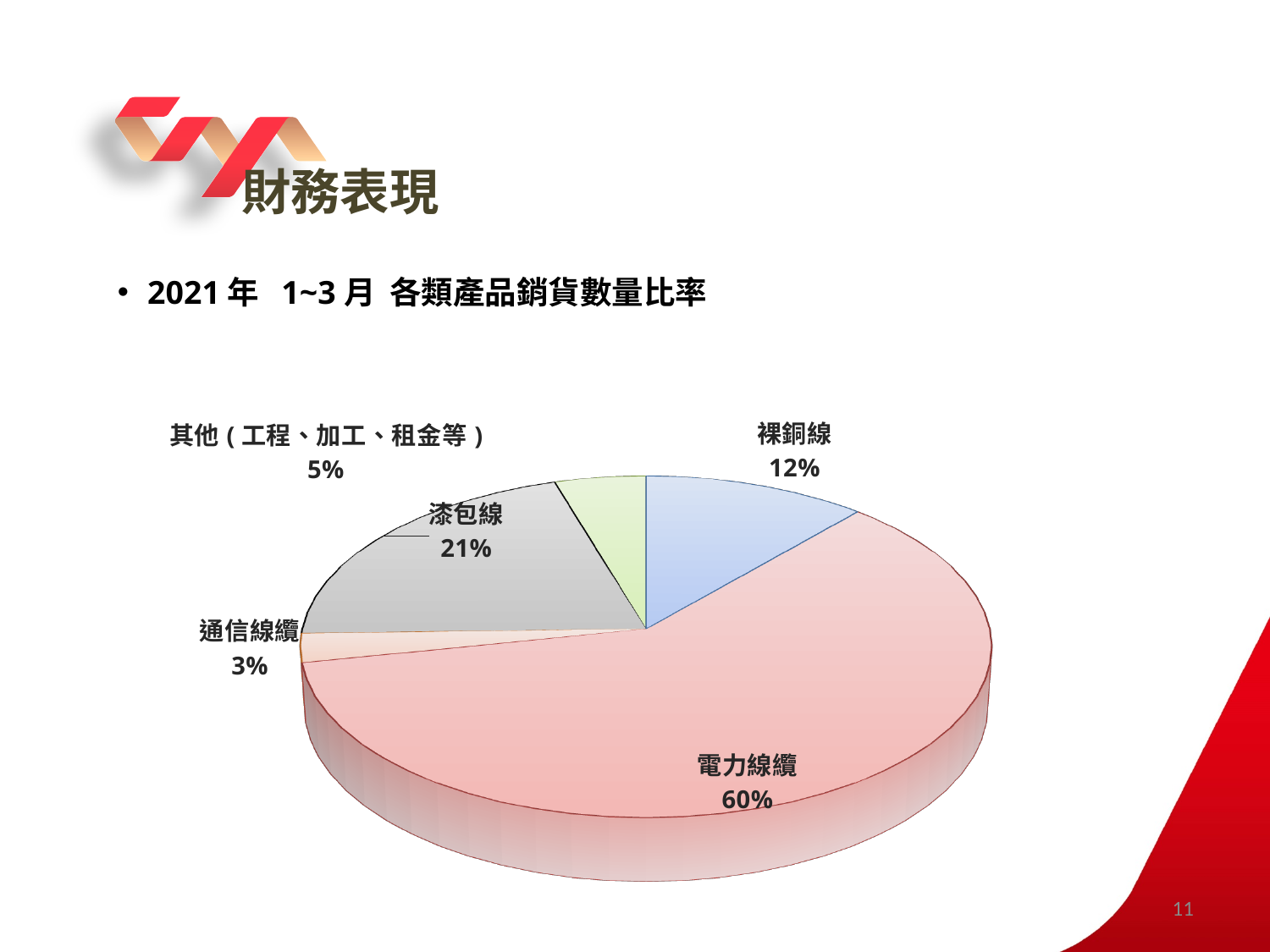
What share of the pie does 其他（工程、加工、租金等） have? 5% Which category has the smallest share of the pie? 通信線纜 Which is larger, the share for 裸銅線 or the share for 其他（工程、加工、租金等）? 裸銅線 What share of the pie does 裸銅線 have? 12% What kind of chart is shown on the slide? pie chart What share of the pie does 電力線纜 have? 60% What share of the pie does 漆包線 have? 21% Which category has the largest share of the pie? 電力線纜 How many categories are shown in the pie chart? 5 What period does the chart's heading say the sales quantity ratios cover? 2021年 1~3月 What share of the pie does 通信線纜 have? 3% What is the difference in percentage points between 電力線纜 and 漆包線? 39